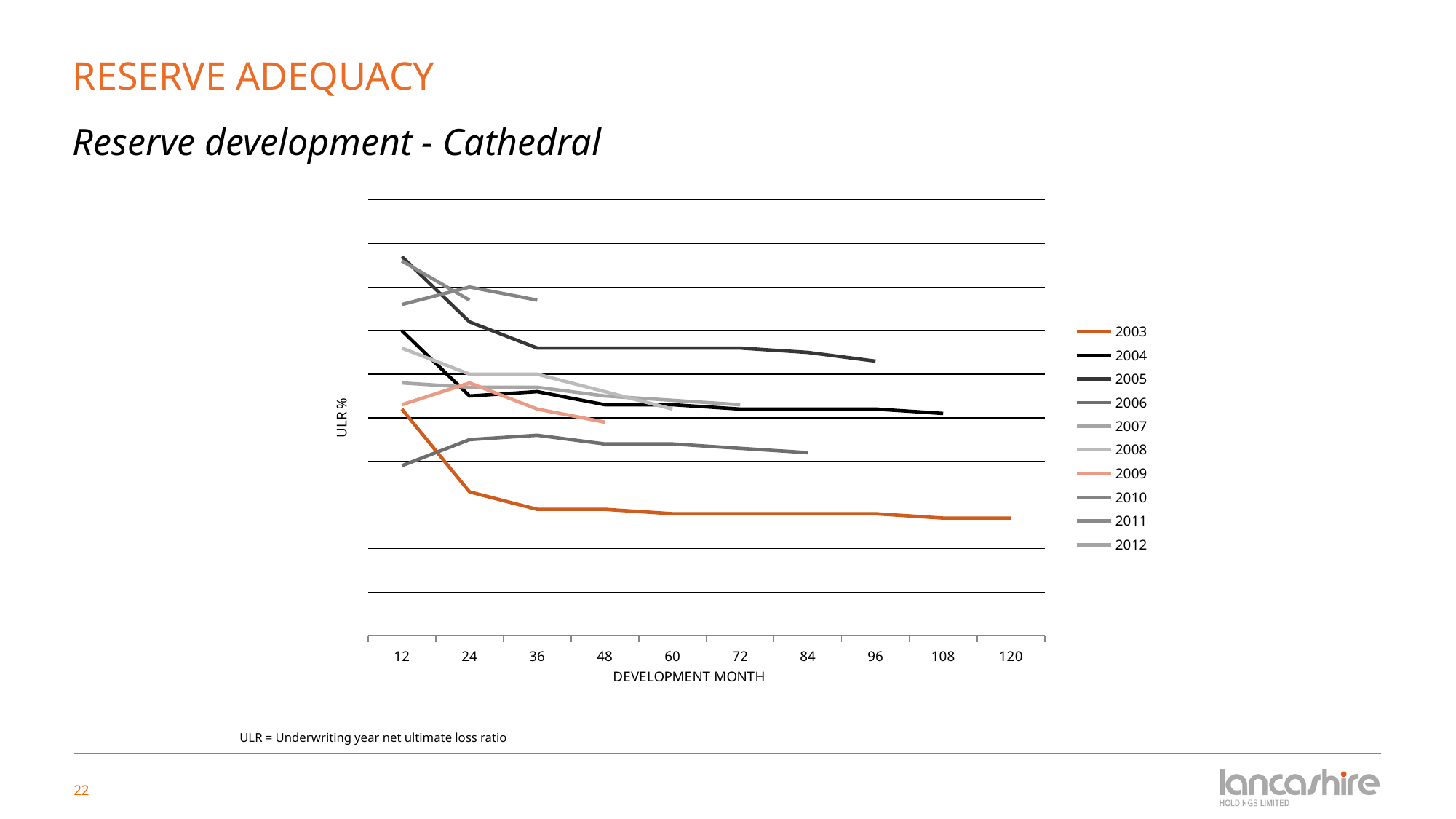
Does the ULR % for the 2003 series rise or fall as the development month increases? Fall Which series has the lowest ULR % across the development months? 2003 What kind of chart is shown on the slide? Line chart How many series does the legend list? 10 Does the ULR % for the 2005 series rise or fall as the development month increases? Fall What is the label of the y axis? ULR % What is the label of the x axis? DEVELOPMENT MONTH At development month 60, which series has the higher ULR %, 2003 or 2005? 2005 How many development month ticks are labelled on the x axis? 10 Which series extends to development month 120? 2003